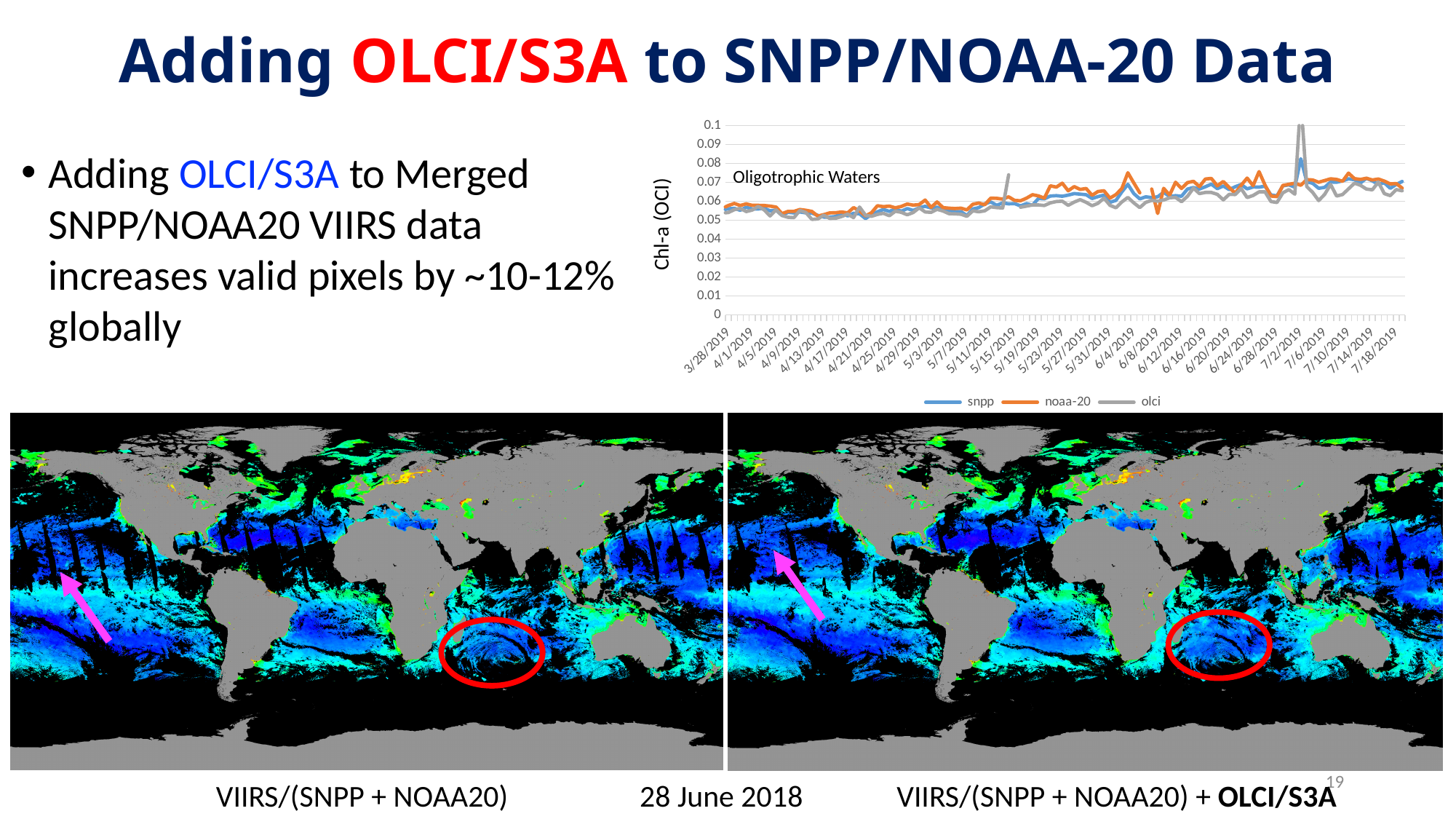
What is the highest tick value shown on the chart's y axis? 0.1 What is the first date label on the chart's x axis? 3/28/2019 Is the peak value of the olci series near 7/2/2019 greater or less than 0.09? greater What is the label on the chart's y axis? Chl-a (OCI) Is the value of the snpp series at 3/28/2019 greater or less than 0.05? greater What kind of chart is shown on the slide? line chart What are the series names listed in the chart's legend? snpp, noaa-20, olci Do the Chl-a values generally rise or fall from late March to July 2019 in the chart? rise Which series reaches the highest value in the chart, at its spike near 7/2/2019? olci Is the value of the noaa-20 series at 3/28/2019 greater or less than 0.07? less How many series does the chart's legend list? 3 What is the last date label on the chart's x axis? 7/18/2019